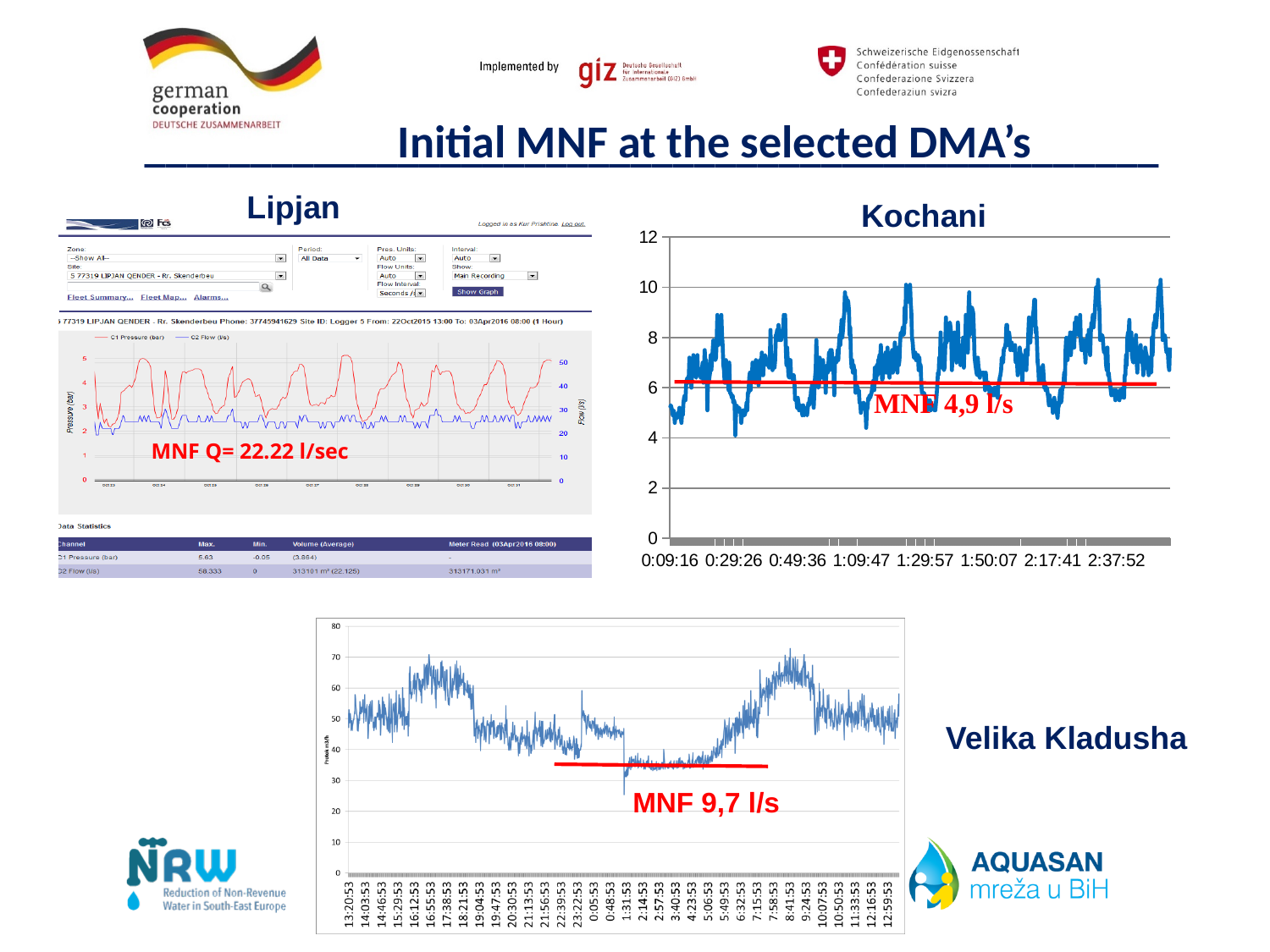
On the Velika Kladusha chart, is the lowest point of the line greater or less than 40? less What MNF value is annotated on the Velika Kladusha chart? 9,7 l/s What kind of chart is the Kochani chart? line chart Which of the three DMAs shown has the highest annotated MNF value? Lipjan What MNF value is annotated on the Kochani chart? 4,9 l/s What is the maximum value shown on the y axis of the Kochani chart? 12 How many series does the legend of the Lipjan chart list? 2 What MNF value is annotated on the Lipjan chart? 22.22 l/sec On the Kochani chart, is the highest point of the line greater or less than 8? greater Which of the three DMAs shown has the lowest annotated MNF value? Kochani What is the difference between the annotated MNF of Velika Kladusha (9,7 l/s) and Kochani (4,9 l/s)? 4,8 l/s Is the annotated MNF for Velika Kladusha larger or smaller than the annotated MNF for Kochani? larger